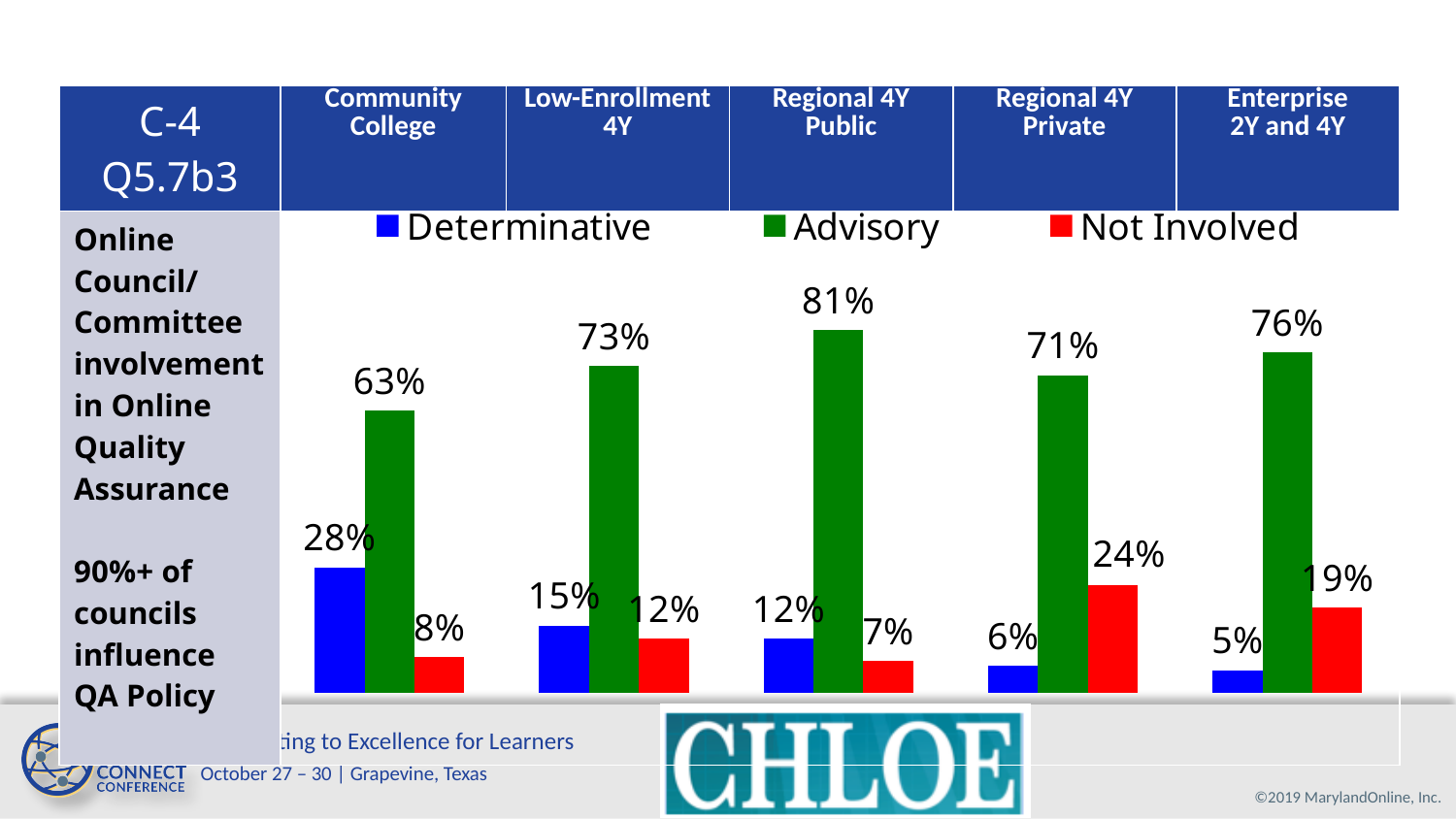
Which category has the highest Advisory value? Regional 4Y Public Which category has the lowest Determinative value? Enterprise 2Y and 4Y What is the difference between the Advisory values for Low-Enrollment 4Y and Community College? 10% What is the Not Involved value for Regional 4Y Private? 24% How many series does the legend list? 3 What is the Advisory value for Regional 4Y Public? 81% How many categories are shown on the x axis? 5 What kind of chart is shown on the slide? Bar chart What is the Advisory value for Enterprise 2Y and 4Y? 76% What is the Determinative value for Community College? 28% Which is larger: the Not Involved value for Regional 4Y Private or for Enterprise 2Y and 4Y? Regional 4Y Private Which colour represents the Not Involved series? Red